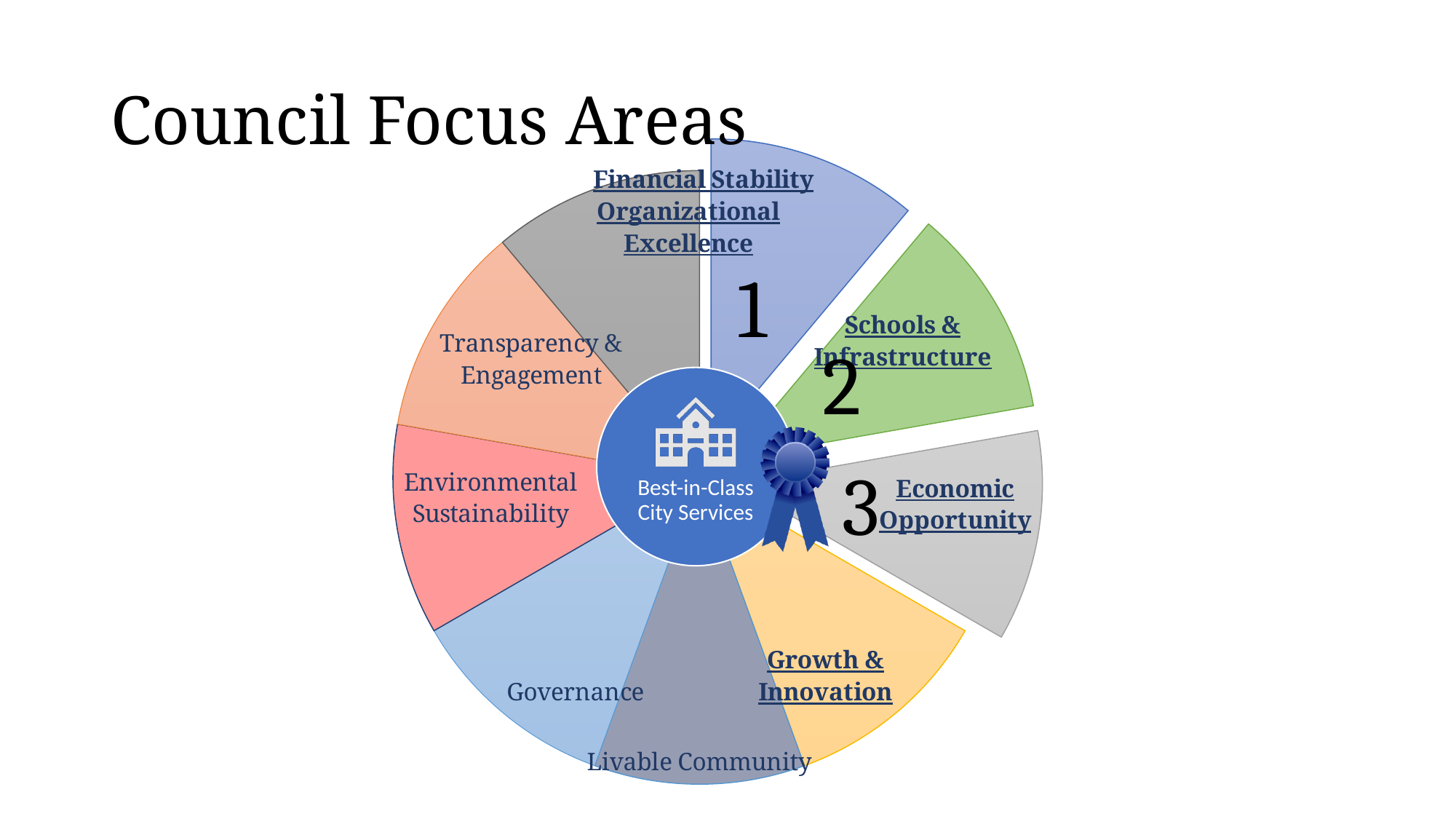
Which slice of the pie chart is labelled with the number 2? Schools & Infrastructure Which slice of the pie chart is coloured yellow? Growth & Innovation How many slices of the pie chart are marked with a number? 3 What colour is the Schools & Infrastructure slice of the pie chart? Green Which slice of the pie chart is coloured red? Environmental Sustainability Which slice of the pie chart is labelled with the number 1? Financial Stability How many slices does the pie chart have? 9 Which slice of the pie chart is labelled with the number 3? Economic Opportunity What kind of chart is shown on the slide? Pie chart